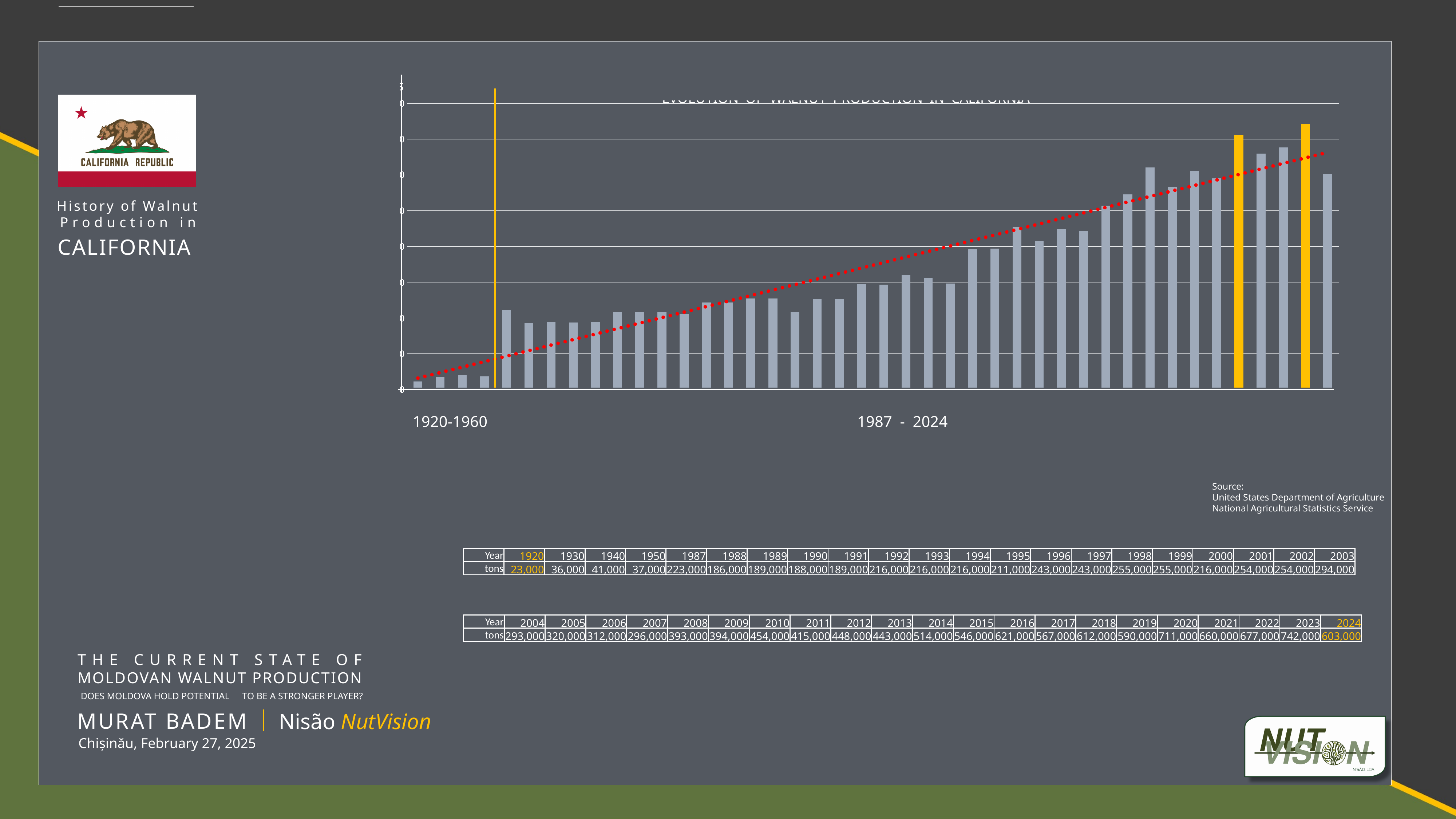
Which year has the lowest walnut production in the chart? 1920 According to the data table, how many tons of walnuts were produced in California in 1920? 23,000 Which year had higher walnut production, 2020 or 2021? 2020 What was California's walnut production in tons in 1987? 223,000 How many years (bars) are plotted in the chart? 42 According to the data table, how many tons of walnuts were produced in California in 2024? 603,000 Does walnut production in California generally rise or fall from 1987 to 2023? rise Which year has the highest walnut production in the chart? 2023 What is the difference in tons between walnut production in 1950 and 1987? 186,000 What colour are the two highlighted bars in the chart? orange/yellow What type of chart is used to show the evolution of walnut production in California? bar chart What is the difference in tons between walnut production in 2023 and 2024? 139,000